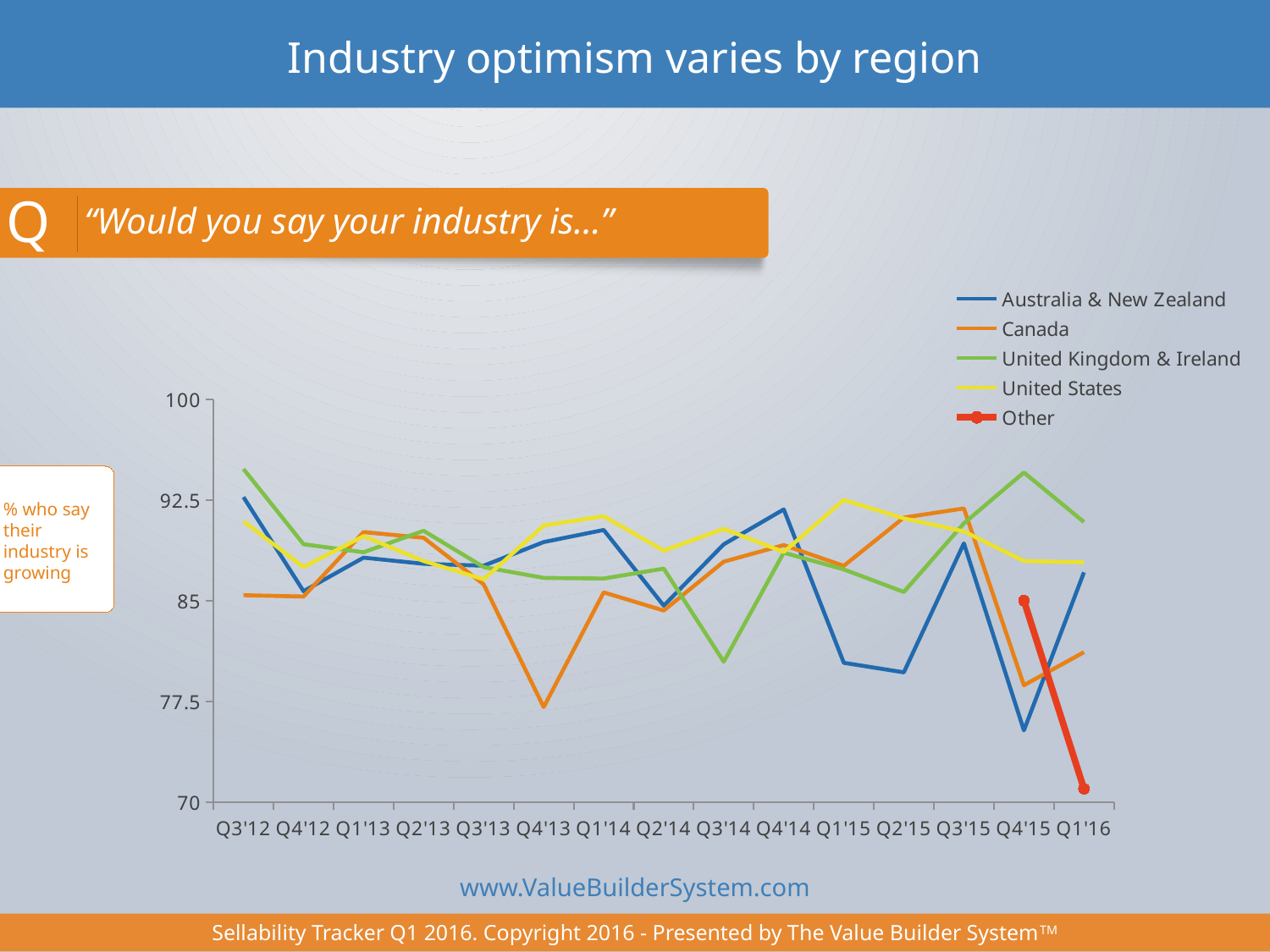
In Q1'16, which is larger: the value for United States or the value for Other? United States Is the value for Canada in Q4'13 greater or less than 85? less What kind of chart is shown on the slide? line chart How many series does the legend list? 5 How many quarters are shown along the x axis? 15 Is the value for United Kingdom & Ireland in Q4'15 greater or less than 92.5? greater Which series has the lowest value in Q1'16? Other Does the Other series rise or fall from Q4'15 to Q1'16? fall Is the value for Australia & New Zealand in Q4'15 greater or less than 77.5? less In which quarter does Canada reach its lowest value? Q4'13 In Q4'13, which is larger: the value for United States or the value for Canada? United States